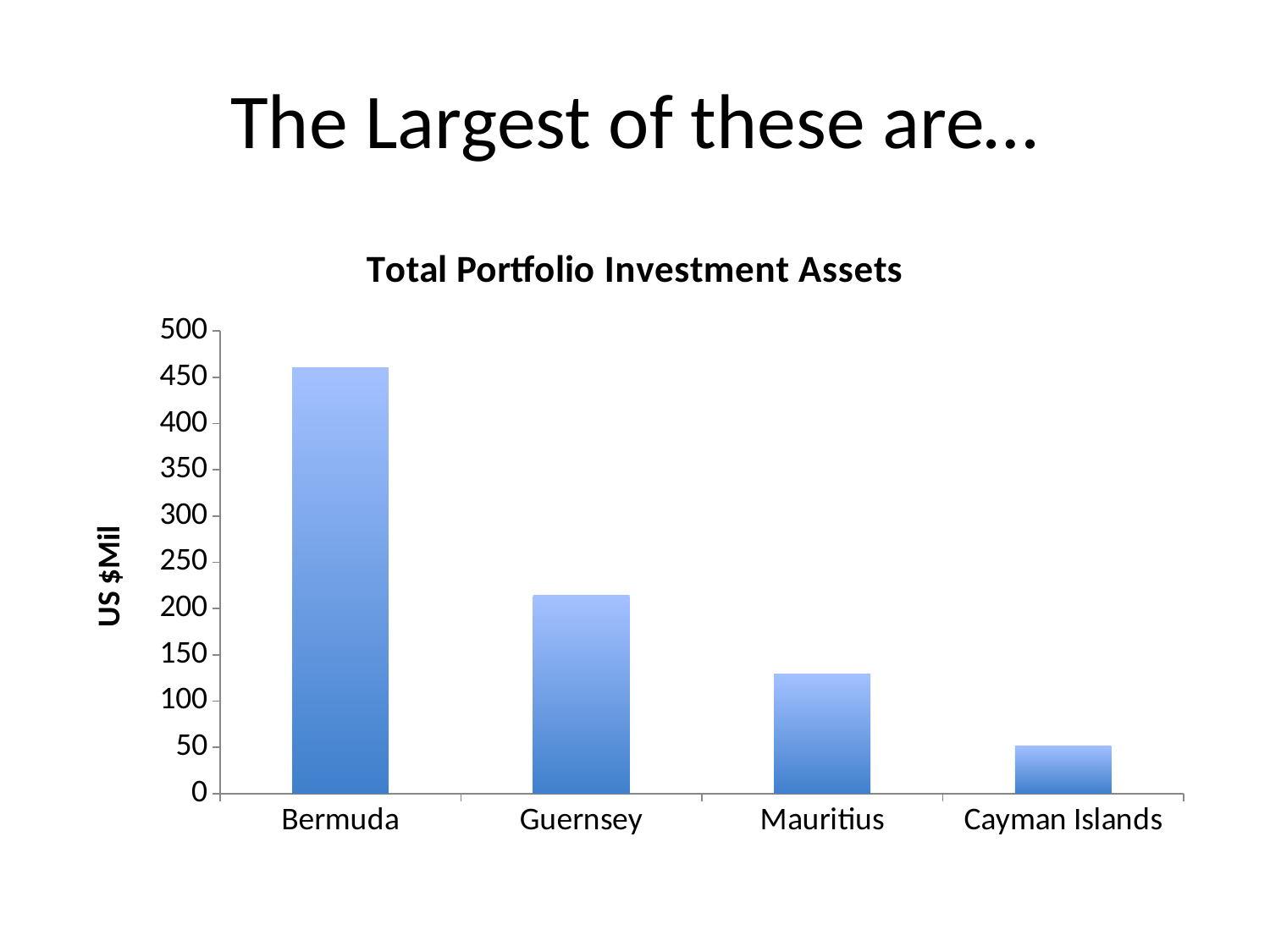
Which category has the highest value? Bermuda Do the values rise or fall from left to right across the categories? fall Is the value for Cayman Islands greater or less than 100? less What is the label on the vertical axis? US $Mil Which category has the lowest value? Cayman Islands Is the value for Mauritius greater or less than 100? greater Is the value for Guernsey greater or less than 250? less Which is larger, the value for Guernsey or the value for Mauritius? Guernsey How many categories are plotted in the chart? 4 What is the title of the chart? Total Portfolio Investment Assets What type of chart is shown on the slide? bar chart